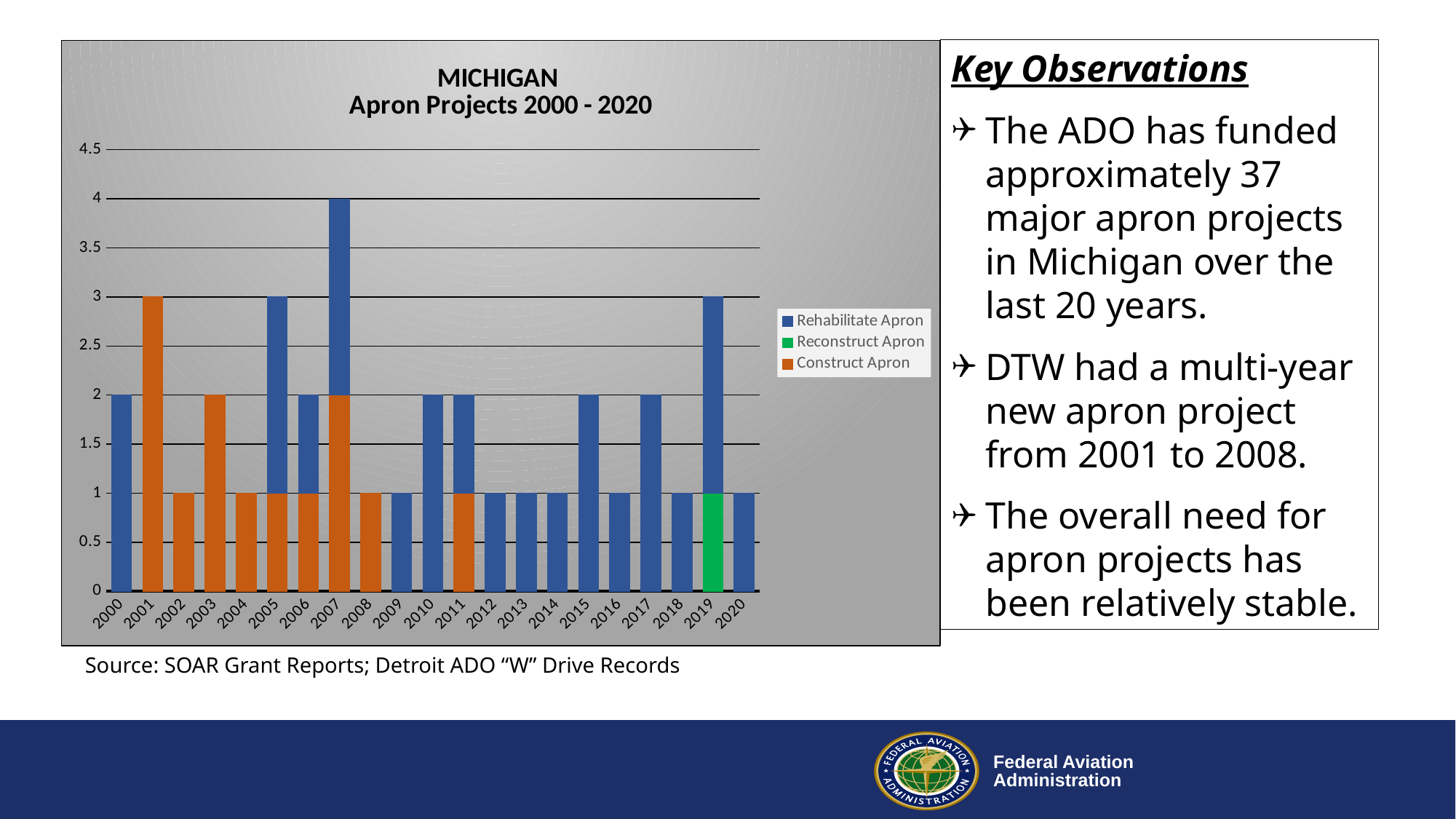
Is the total value for 2007 greater or less than 3.5? greater Which series is shown in green in the legend? Reconstruct Apron How many years are shown along the x axis? 21 What is the title of the chart? MICHIGAN Apron Projects 2000 - 2020 How many series does the legend list? 3 What is the total height of the stacked bar for 2007? 4 Which year has the tallest bar? 2007 What is the total height of the stacked bar for 2019? 3 What kind of chart is shown on the slide? bar chart What is the value for Rehabilitate Apron in 2000? 2 Which is larger, the bar for 2010 or the bar for 2012? 2010 What is the value for Construct Apron in 2001? 3